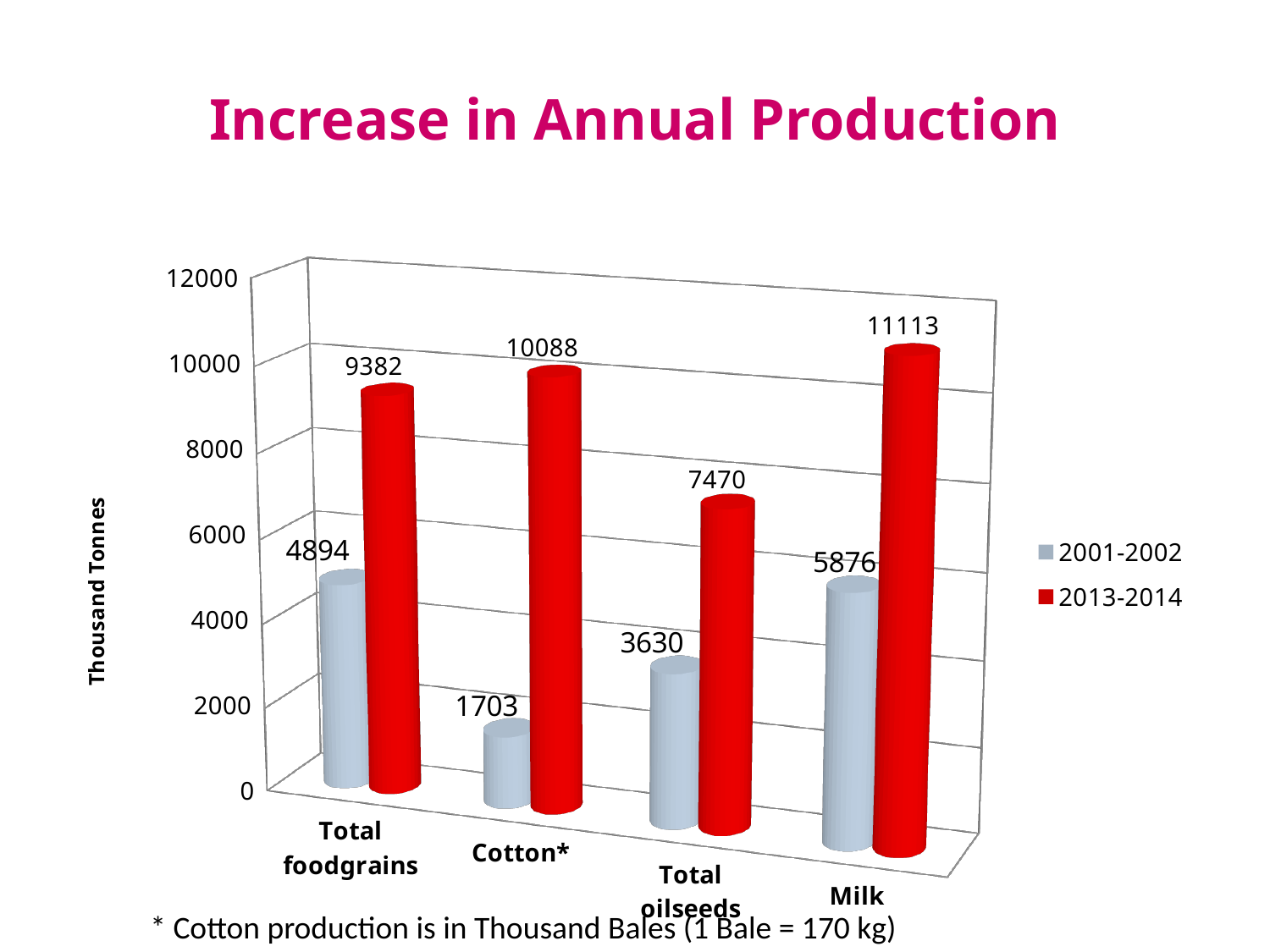
Which category has the lowest 2001-2002 value? Cotton* What is the 2013-2014 value for Cotton*? 10088 Which is larger: the 2013-2014 value for Total oilseeds or the 2013-2014 value for Total foodgrains? Total foodgrains What kind of chart is shown on the slide? Bar chart How many categories are shown on the x axis? 4 What is the 2001-2002 value for Milk? 5876 What is the label on the vertical axis? Thousand Tonnes What is the title of the chart? Increase in Annual Production How many series does the legend list? 2 What is the 2001-2002 value for Total oilseeds? 3630 What is the difference between the 2013-2014 and 2001-2002 values for Total foodgrains? 4488 Which category has the highest 2013-2014 value? Milk